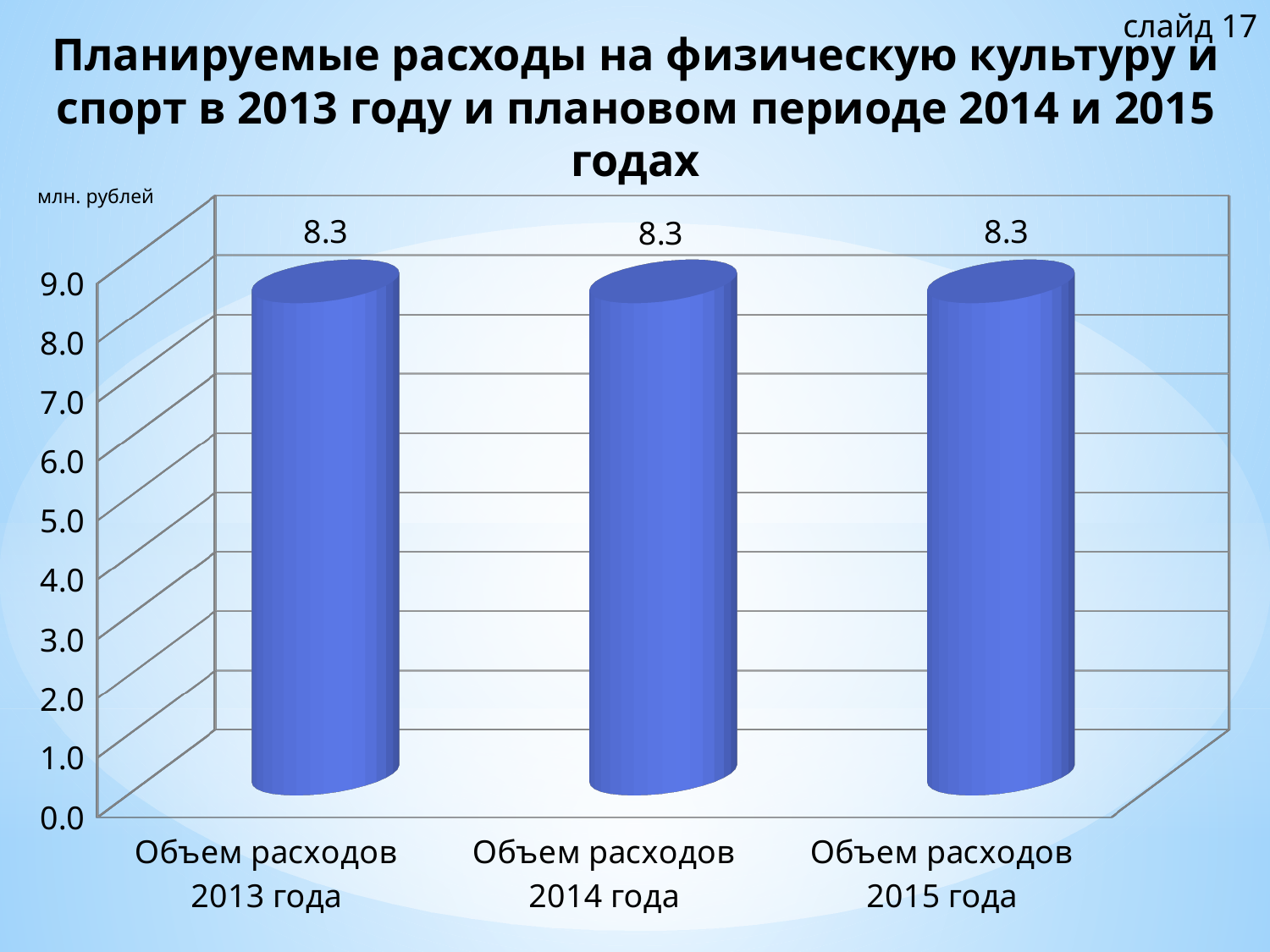
What is the difference between the values for Объем расходов 2015 года and Объем расходов 2013 года? 0.0 What is the total of the three values shown on the chart? 24.9 What is the title of the chart? Планируемые расходы на физическую культуру и спорт в 2013 году и плановом периоде 2014 и 2015 годах What is the value for Объем расходов 2013 года? 8.3 How many categories are shown on the chart? 3 What is the value for Объем расходов 2014 года? 8.3 What is the value for Объем расходов 2015 года? 8.3 What unit is indicated for the values on the chart? млн. рублей Do the values rise, fall or stay the same from 2013 to 2015? Stay the same Is the value for Объем расходов 2013 года greater or less than 9.0? less Is the value for Объем расходов 2014 года greater or less than 5.0? greater What kind of chart is shown on the slide? Bar chart